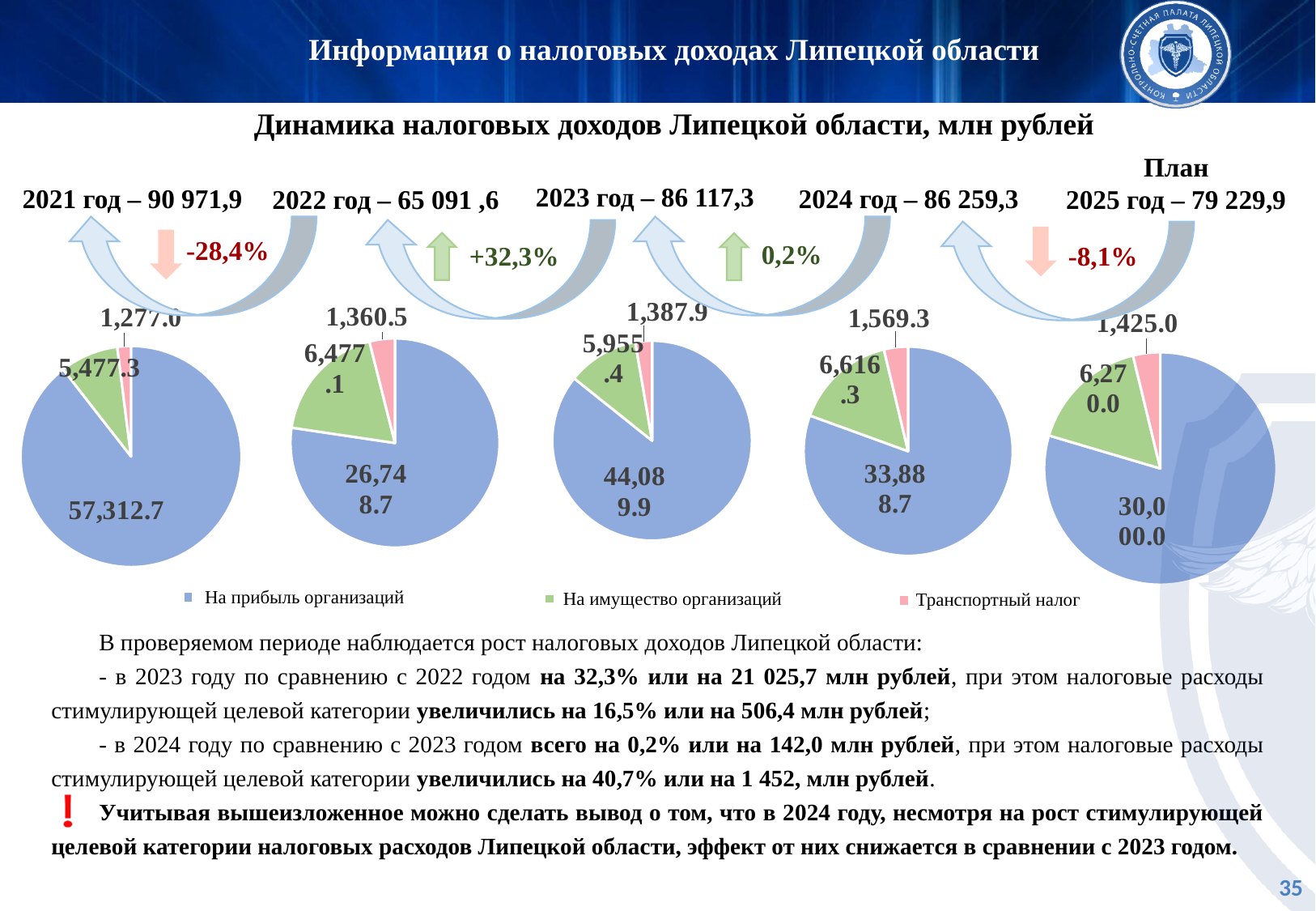
In the План 2025 pie chart, which category has the smallest slice? Транспортный налог Which is larger: На прибыль организаций in the 2021 pie chart or in the 2022 pie chart? 2021 In the 2024 pie chart, what is the value for Транспортный налог? 1,569.3 How many slices does each pie chart have? 3 In the 2022 pie chart, what is the value for На имущество организаций? 6,477.1 What kind of charts are shown on the slide? Pie charts In the 2024 pie chart, what is the difference between На имущество организаций and Транспортный налог? 5,047.0 How many entries does the legend list? 3 In the План 2025 pie chart, what is the total of the three slices? 37,695.0 How many pie charts are shown on the slide? 5 In the 2023 pie chart, which category has the largest slice? На прибыль организаций In the 2021 pie chart, what is the value for На прибыль организаций? 57,312.7